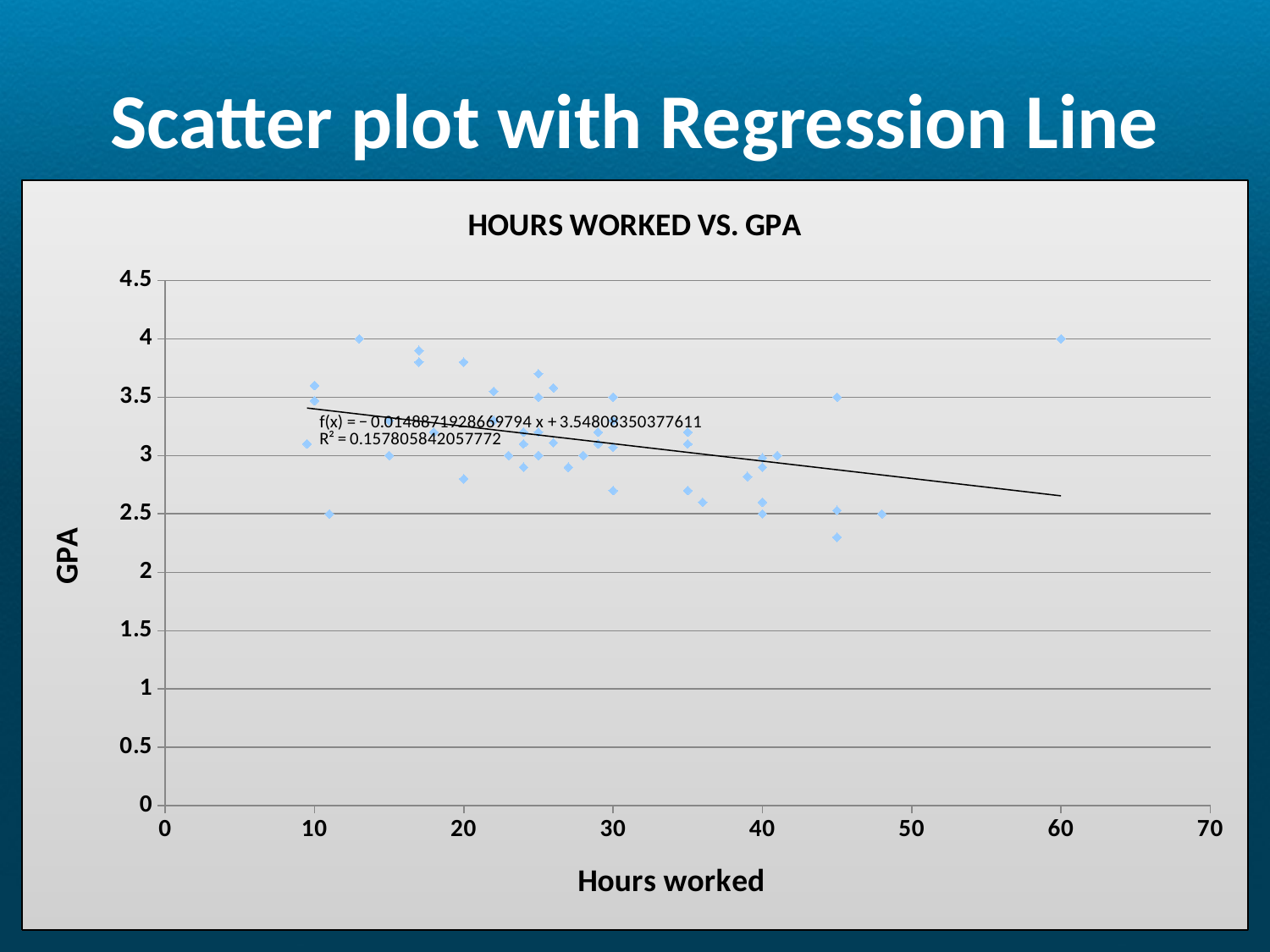
Is the GPA of the data point at 60 hours worked greater or less than 3.5? greater What R² value is printed on the chart? R² = 0.157805842057772 What is the label of the x axis? Hours worked Is the regression line's value at 60 hours worked greater or less than 3? less Is the GPA of the data point at 11 hours worked greater or less than 3? less What is the slope of the regression equation shown on the chart? −0.0148871928669794 According to the regression line, does GPA tend to rise or fall as hours worked increases? Fall What is the intercept of the regression equation shown on the chart? 3.54808350377611 What type of chart is shown on the slide? Scatter plot What is the highest value shown on the Hours worked axis? 70 What is the title of the chart? HOURS WORKED VS. GPA What is the highest value shown on the GPA axis? 4.5